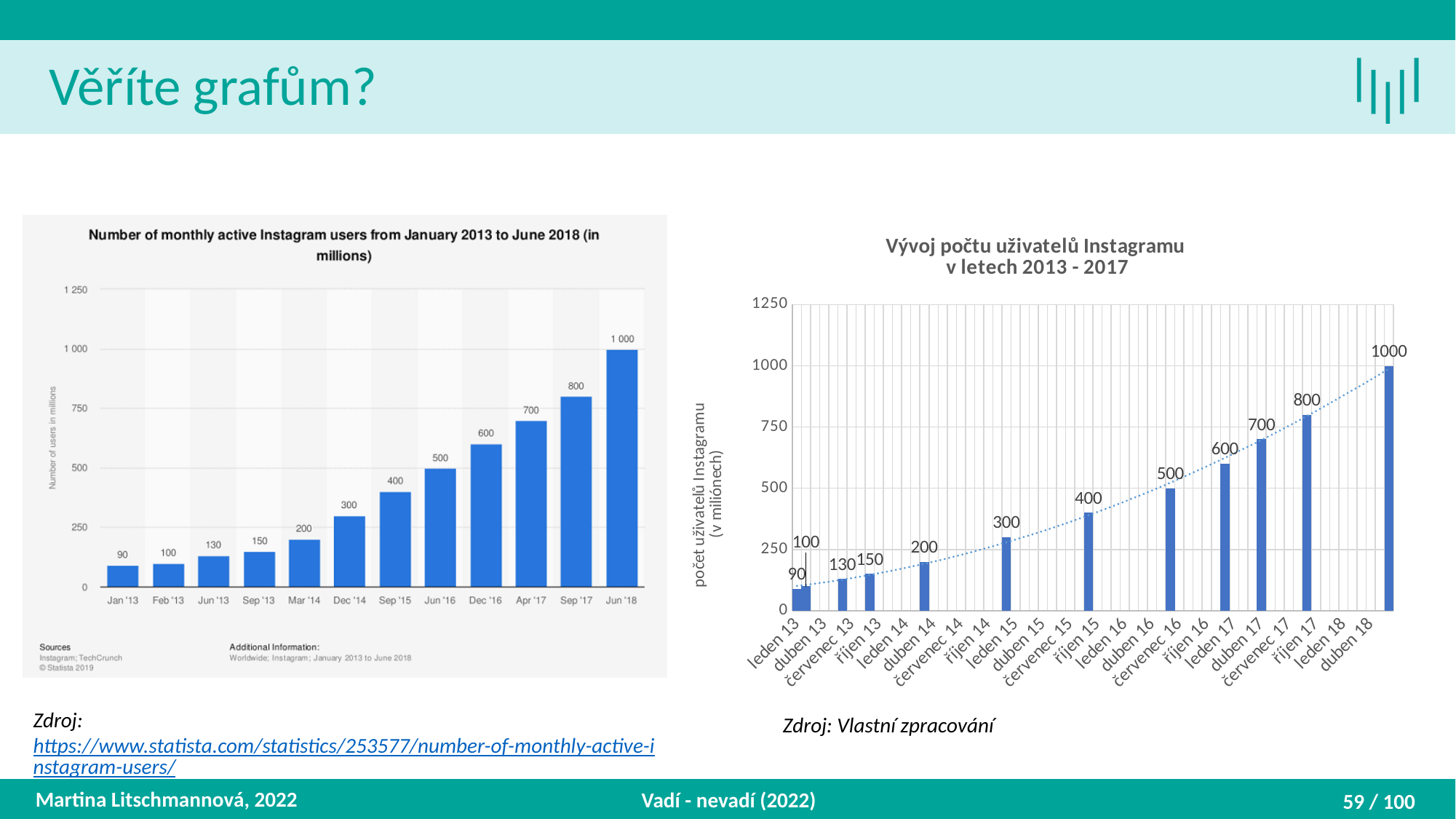
In the left chart, which category has the highest value? Jun '18 In the left chart, what is the number of monthly active Instagram users for Jun '18? 1 000 In the right chart, what is the difference between the data labels 400 and 300? 100 In the right chart, what is the lowest data label shown? 90 In the left chart, do the values rise or fall from Jan '13 to Jun '18? rise What type of chart is the chart on the right, titled 'Vývoj počtu uživatelů Instagramu v letech 2013 - 2017'? bar chart What is the y-axis label of the right chart? počet uživatelů Instagramu (v miliónech) In the left chart, what is the value for Dec '14? 300 In the left chart, what is the difference between the values for Sep '17 and Apr '17? 100 In the left chart, which category has the lowest value? Jan '13 In the right chart, what is the highest data label shown? 1000 In the left chart, how many bars are plotted? 12